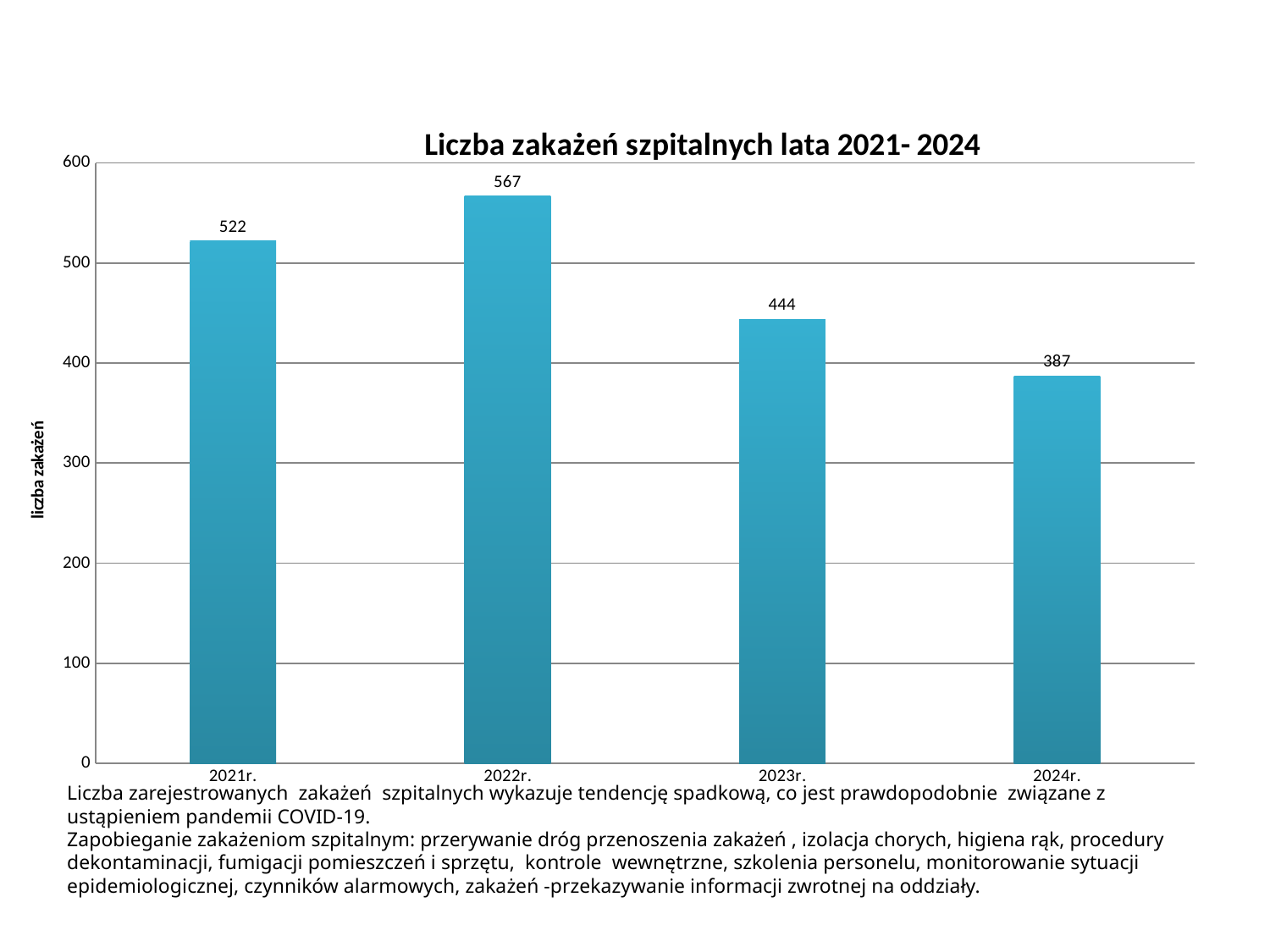
What is the number of hospital infections shown for 2023r.? 444 Which year has the lowest number of hospital infections? 2024r. Which year has the highest number of hospital infections? 2022r. What kind of chart is shown on the slide? bar chart What is the difference between the values for 2021r. and 2023r.? 78 What is the difference between the values for 2022r. and 2024r.? 180 Which is larger, the value for 2021r. or the value for 2023r.? 2021r. How many years (categories) are shown on the chart? 4 What is the number of hospital infections shown for 2024r.? 387 What is the number of hospital infections shown for 2021r.? 522 What is the number of hospital infections shown for 2022r.? 567 What is the title of the chart? Liczba zakażeń szpitalnych lata 2021- 2024